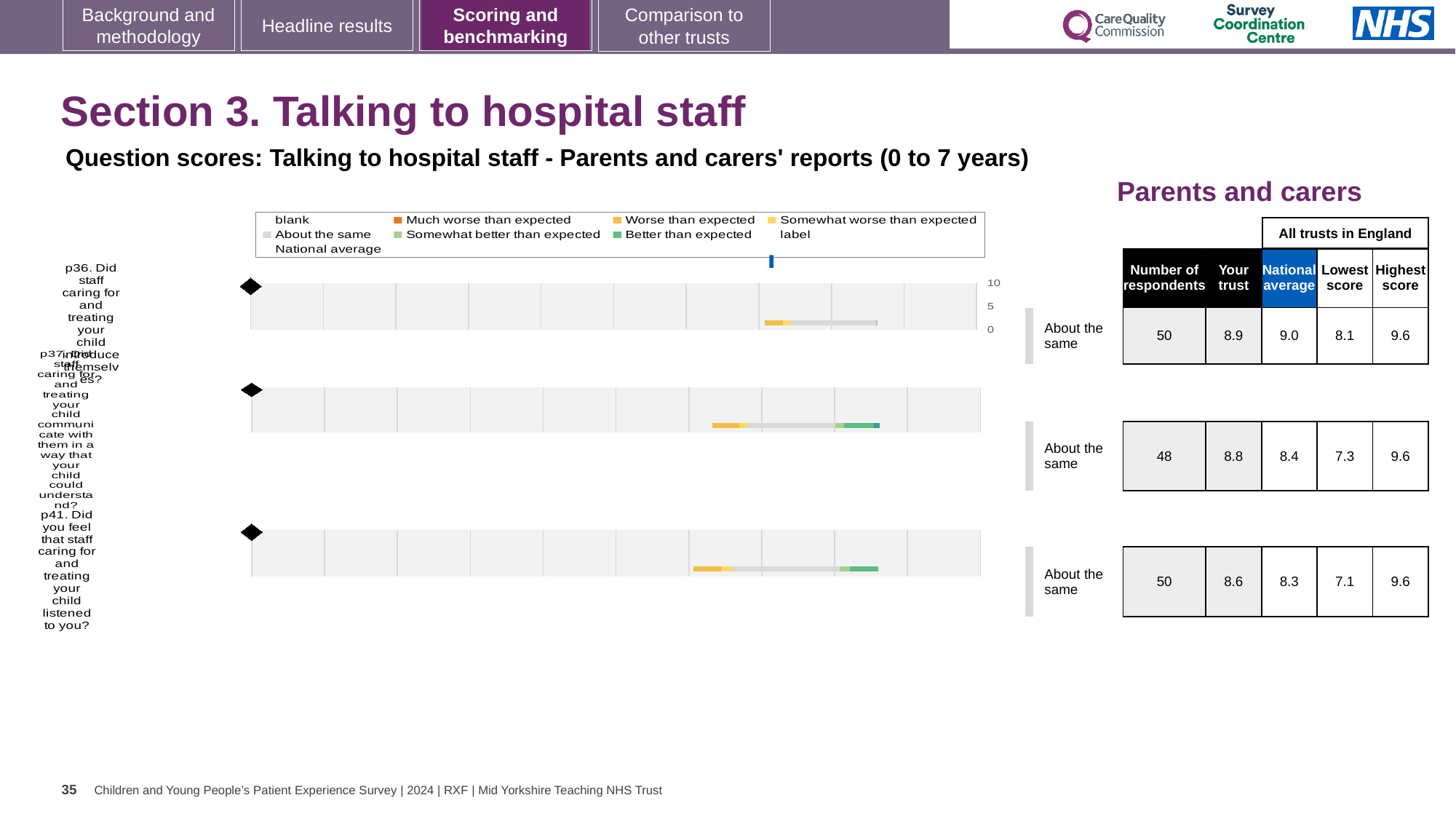
Which question has the lowest 'Your trust' score? p41 What is the 'Your trust' score for p36 (Did staff caring for and treating your child introduce themselves)? 8.9 Which question has the highest 'Your trust' score? p36 What colour does the legend use for 'Much worse than expected'? orange What kind of chart is used to show the question scores for Talking to hospital staff? bar chart How many respondents answered p37? 48 What is the lowest score among all trusts in England for p41 (Did you feel that staff listened to you)? 7.1 How many entries does the chart legend list? 9 What is the national average score for p37 (Did staff communicate with your child in a way they could understand)? 8.4 For p37, which is larger: the 'Your trust' score or the national average? Your trust How many survey questions (categories) are plotted in the chart? 3 For p41, what is the difference between the highest score and the lowest score among all trusts in England? 2.5